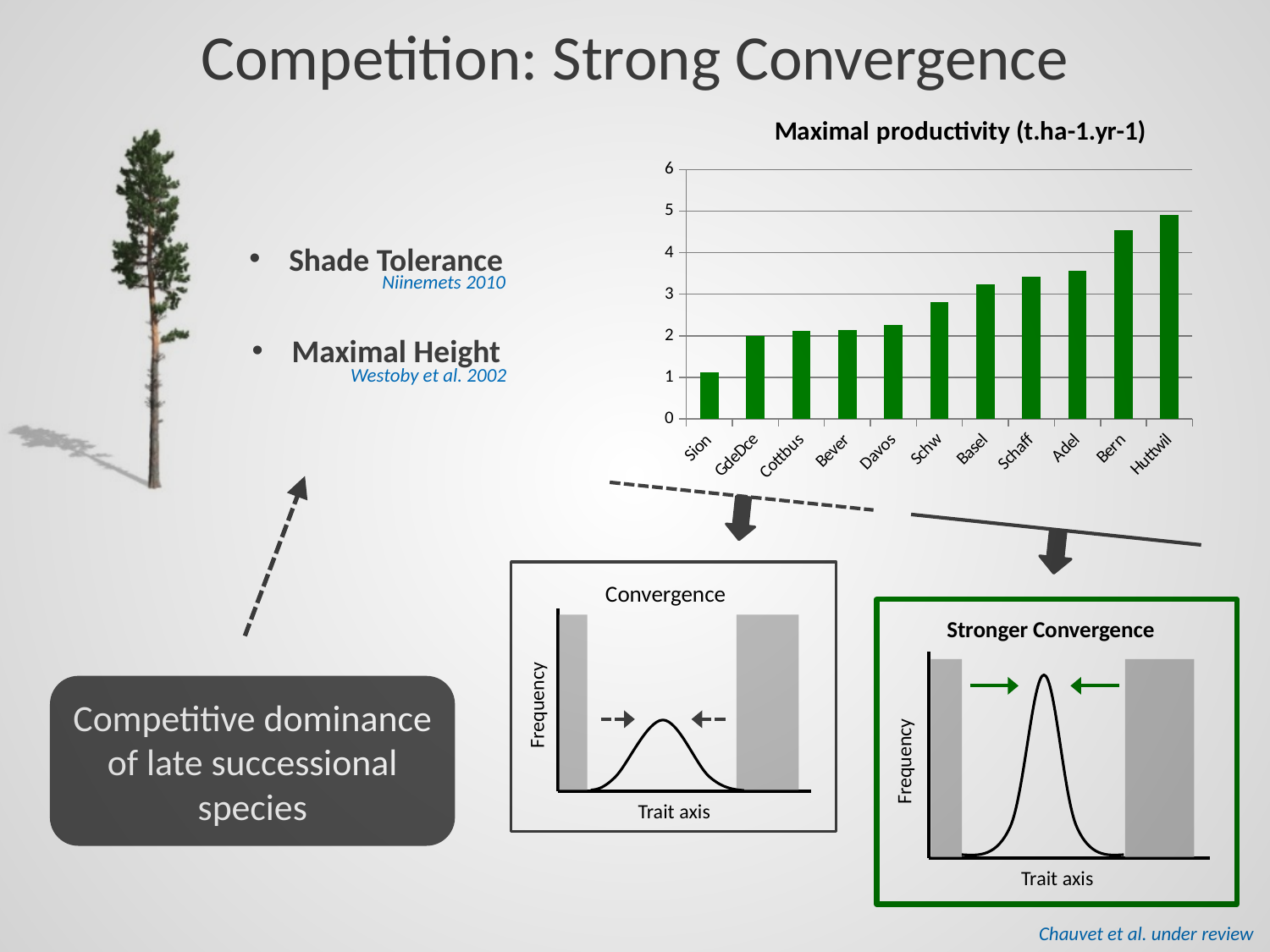
In the 'Maximal productivity' chart, which site has the highest value? Huttwil In the 'Maximal productivity' chart, which site has the lowest value? Sion In the 'Maximal productivity' chart, do the bar values rise or fall from left to right along the x axis? rise In the 'Maximal productivity' chart, is the value for Sion greater or less than 2? less In the 'Maximal productivity' chart, is the value for Schw greater or less than 3? less How many sites (categories) are plotted in the 'Maximal productivity' bar chart? 11 In the 'Maximal productivity' chart, is the value for Bern greater or less than 4? greater What kind of chart is shown under the title 'Maximal productivity (t.ha-1.yr-1)'? bar chart What colour are the bars in the 'Maximal productivity' chart? green In the 'Maximal productivity' chart, which site has the larger value, Sion or Davos? Davos In the 'Maximal productivity' chart, which site has the larger value, Bern or Adel? Bern